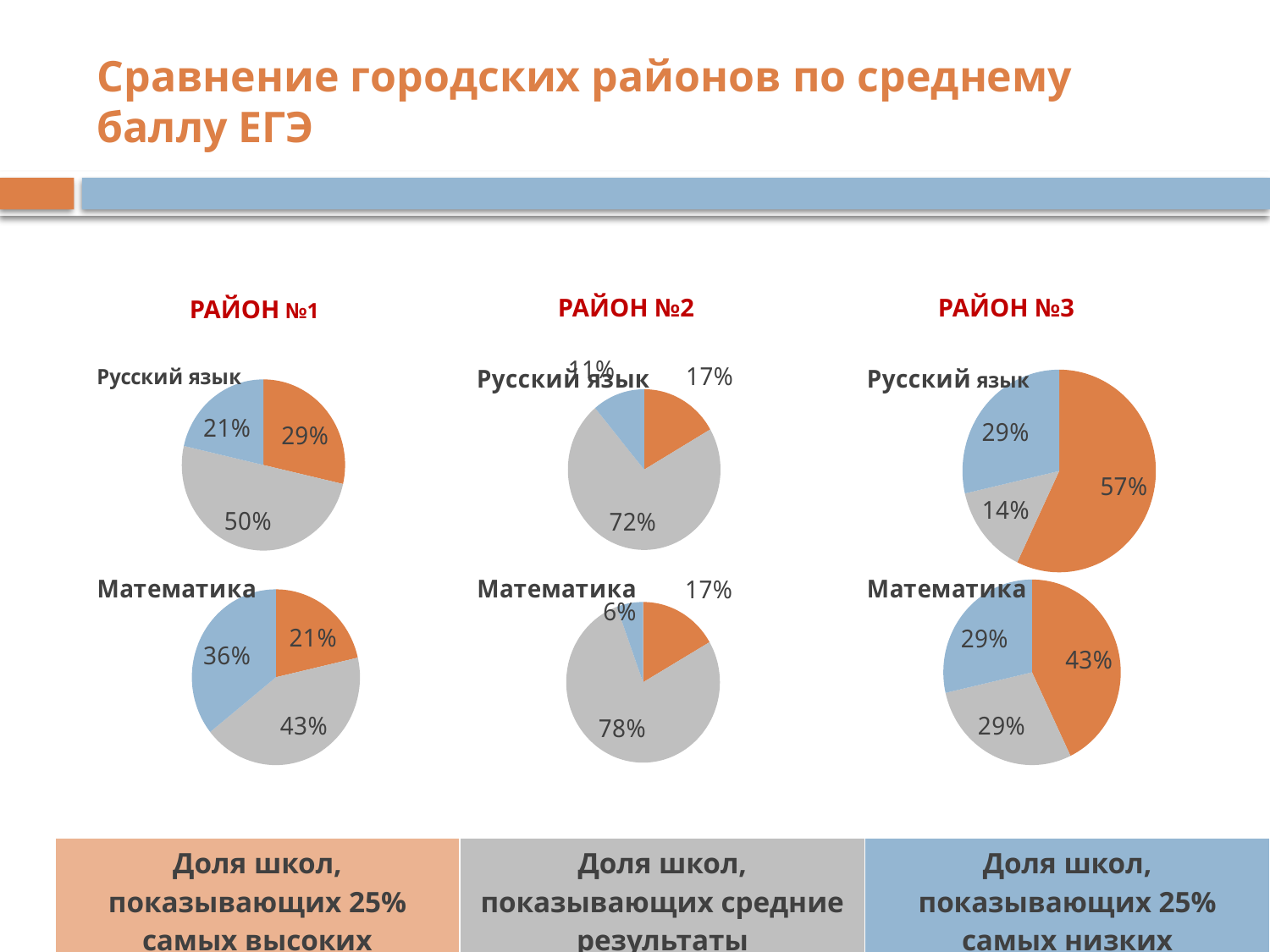
In the Русский язык pie chart for РАЙОН №1, which is larger: the orange slice or the blue slice? the orange slice (29%) According to the legend at the bottom, what does the grey colour represent? Доля школ, показывающих средние результаты How many pie charts are on the slide? 6 What type of charts are shown on the slide? pie charts In the Русский язык pie chart for РАЙОН №2, what share of schools shows the 25% highest results (orange slice)? 17% In the Математика pie chart for РАЙОН №2, what is the smallest slice? 6% In the Математика pie chart for РАЙОН №3, what share of schools shows the 25% highest results (orange slice)? 43% In the Русский язык pie chart for РАЙОН №1, what share of schools shows average results (grey slice)? 50% In the Русский язык pie chart for РАЙОН №3, what is the largest slice? 57% How many slices does the Математика pie chart for РАЙОН №3 have? 3 In the Математика pie chart for РАЙОН №1, what share of schools shows the 25% lowest results (blue slice)? 36% In the Математика pie chart for РАЙОН №2, what is the difference between the grey slice (78%) and the orange slice (17%)? 61%